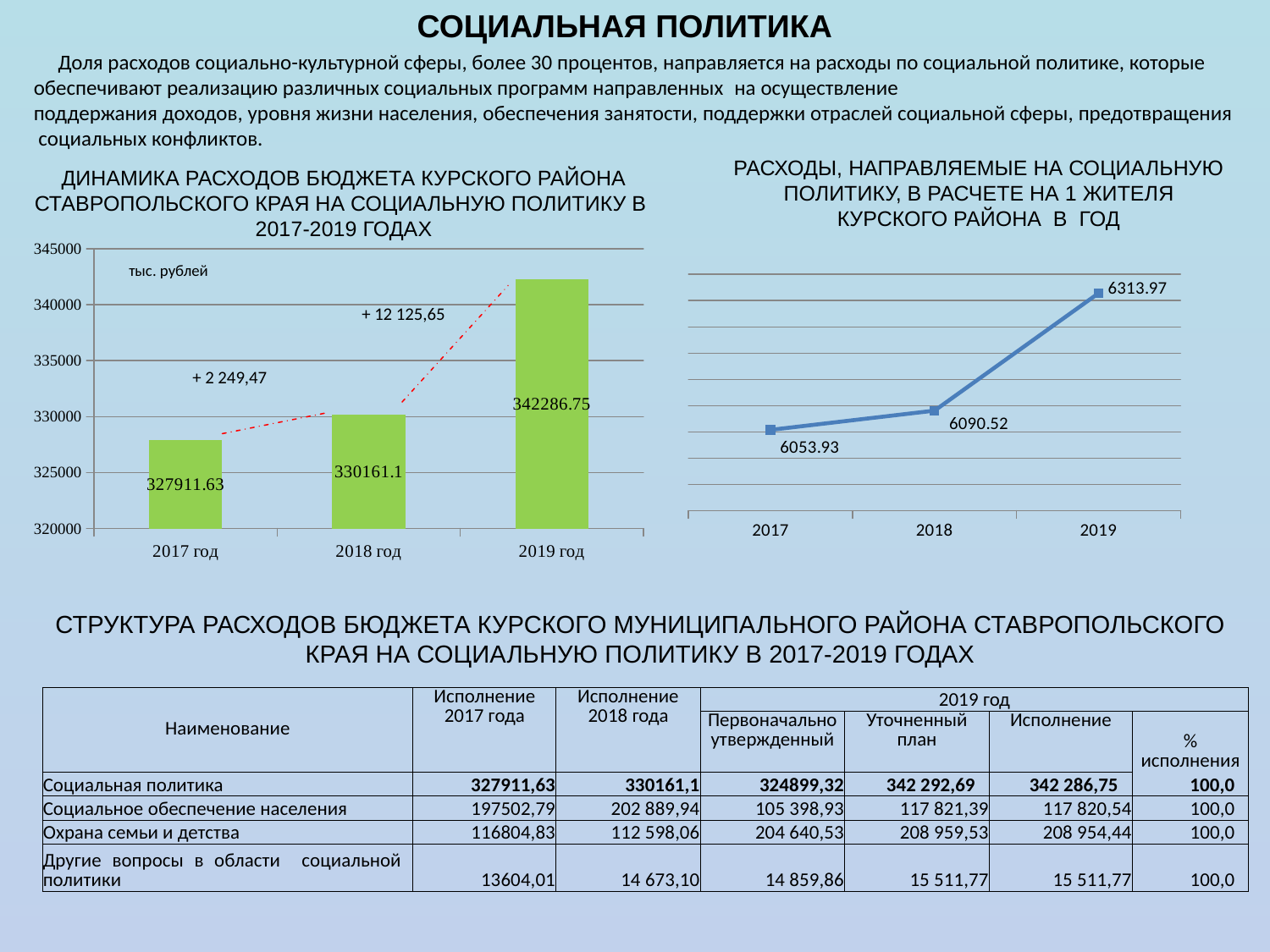
In the right line chart (expenditures per 1 resident), which year has the highest value? 2019 In the left bar chart, what is the difference between the 2019 год and 2018 год values? 12125.65 In the left bar chart, do the values rise or fall from 2017 год to 2019 год? rise In the left bar chart, which year has the lowest value? 2017 год In the left bar chart (dynamics of social policy expenditures), what is the value for 2017 год? 327911.63 What type of chart is the right chart on the slide? line chart What type of chart is the left chart on the slide? bar chart In the right line chart, what is the difference between the 2019 and 2018 values? 223.45 In the left bar chart, how many bars are plotted? 3 In the right line chart (expenditures per 1 resident), what is the value for 2018? 6090.52 In the left bar chart (dynamics of social policy expenditures), what is the value for 2019 год? 342286.75 What unit label is shown inside the left bar chart? тыс. рублей